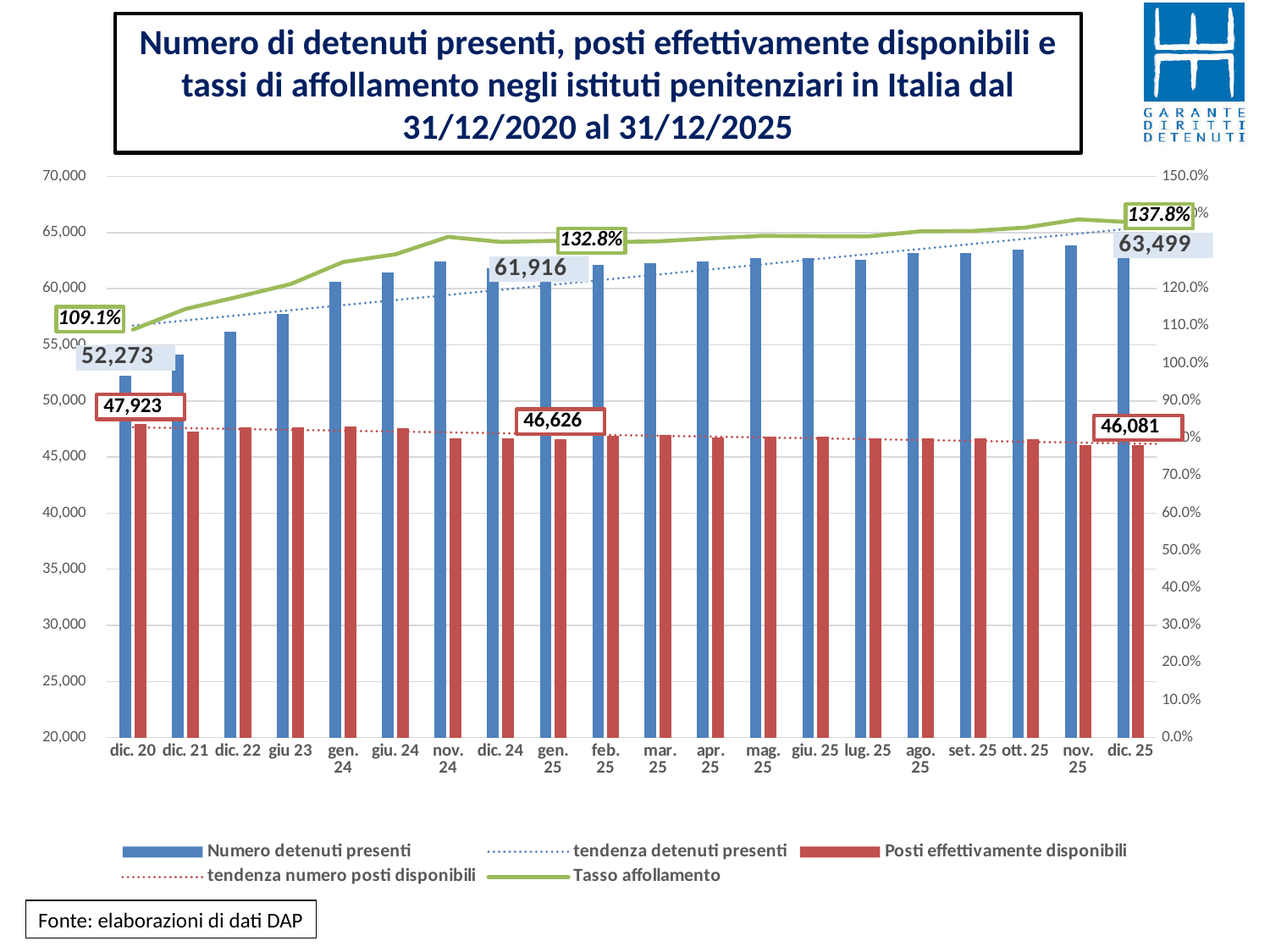
What is the value of Posti effettivamente disponibili for dic. 20? 47,923 Which period has the lowest value of Numero detenuti presenti? dic. 20 How many periods are shown on the x axis? 20 By how much did Numero detenuti presenti increase from dic. 20 to dic. 25? 11,226 What is the value of Numero detenuti presenti for dic. 20? 52,273 How many series does the legend list? 5 Is the value of Numero detenuti presenti for giu 23 greater or less than 55,000? greater What is the value of Posti effettivamente disponibili for dic. 25? 46,081 What is the difference between Posti effettivamente disponibili in dic. 20 and in dic. 25? 1,842 Does the Tasso affollamento line rise or fall from dic. 20 to dic. 25? rise What is the value of Numero detenuti presenti for dic. 25? 63,499 What is the Tasso affollamento for dic. 25? 137.8%